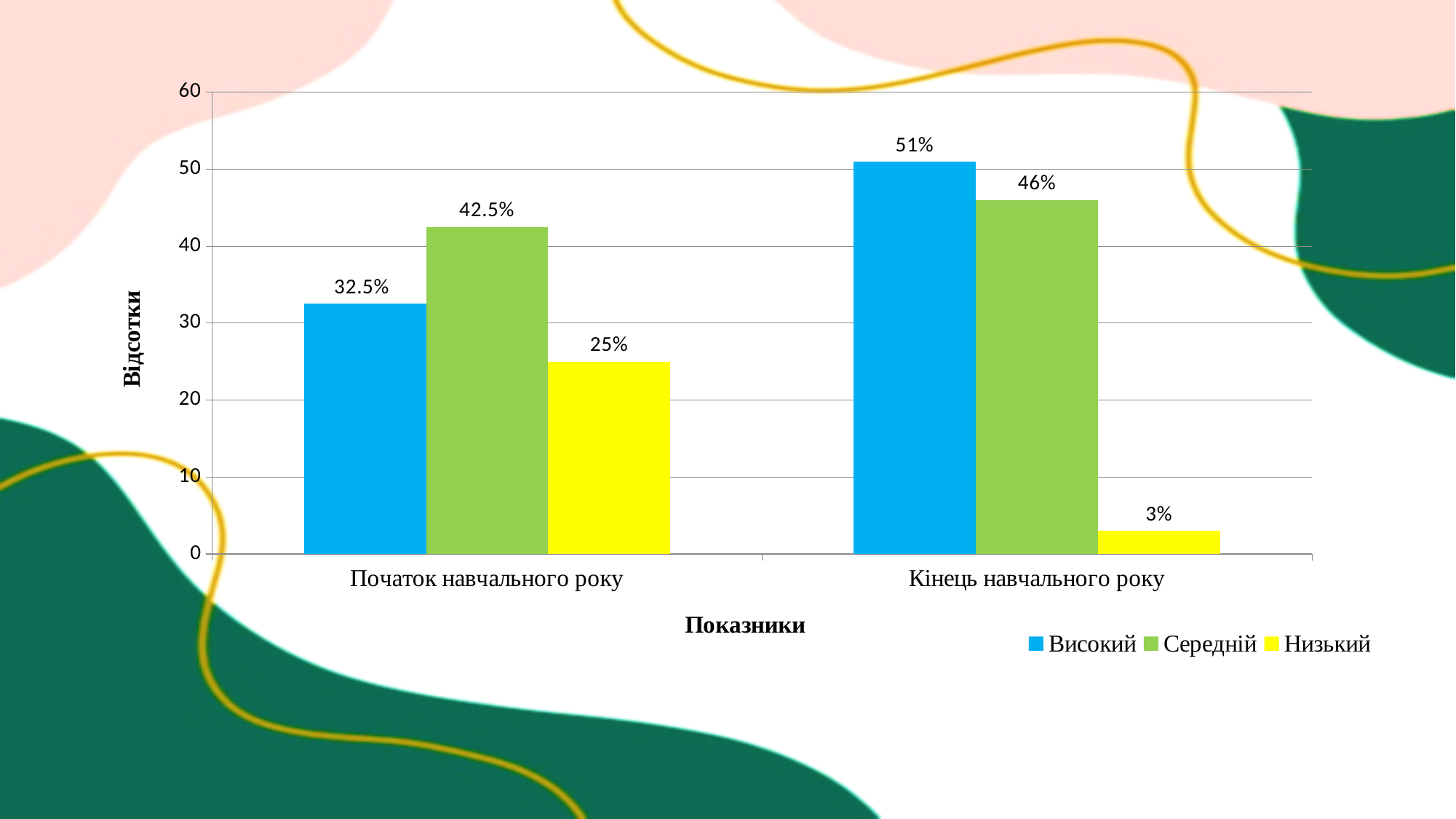
How many categories are shown on the x axis? 2 What is the value for Низький at Кінець навчального року? 3% Which series has the lowest value at Початок навчального року? Низький What kind of chart is shown on the slide? Bar chart How many series does the legend list? 3 Which series has the highest value at Кінець навчального року? Високий Which is larger: Високий at Початок навчального року or Середній at Початок навчального року? Середній at Початок навчального року What is the difference between the Середній values at Кінець навчального року and Початок навчального року? 3.5% What is the label of the y axis? Відсотки What is the value for Високий at Початок навчального року? 32.5% What is the value for Середній at Початок навчального року? 42.5% What is the value for Високий at Кінець навчального року? 51%